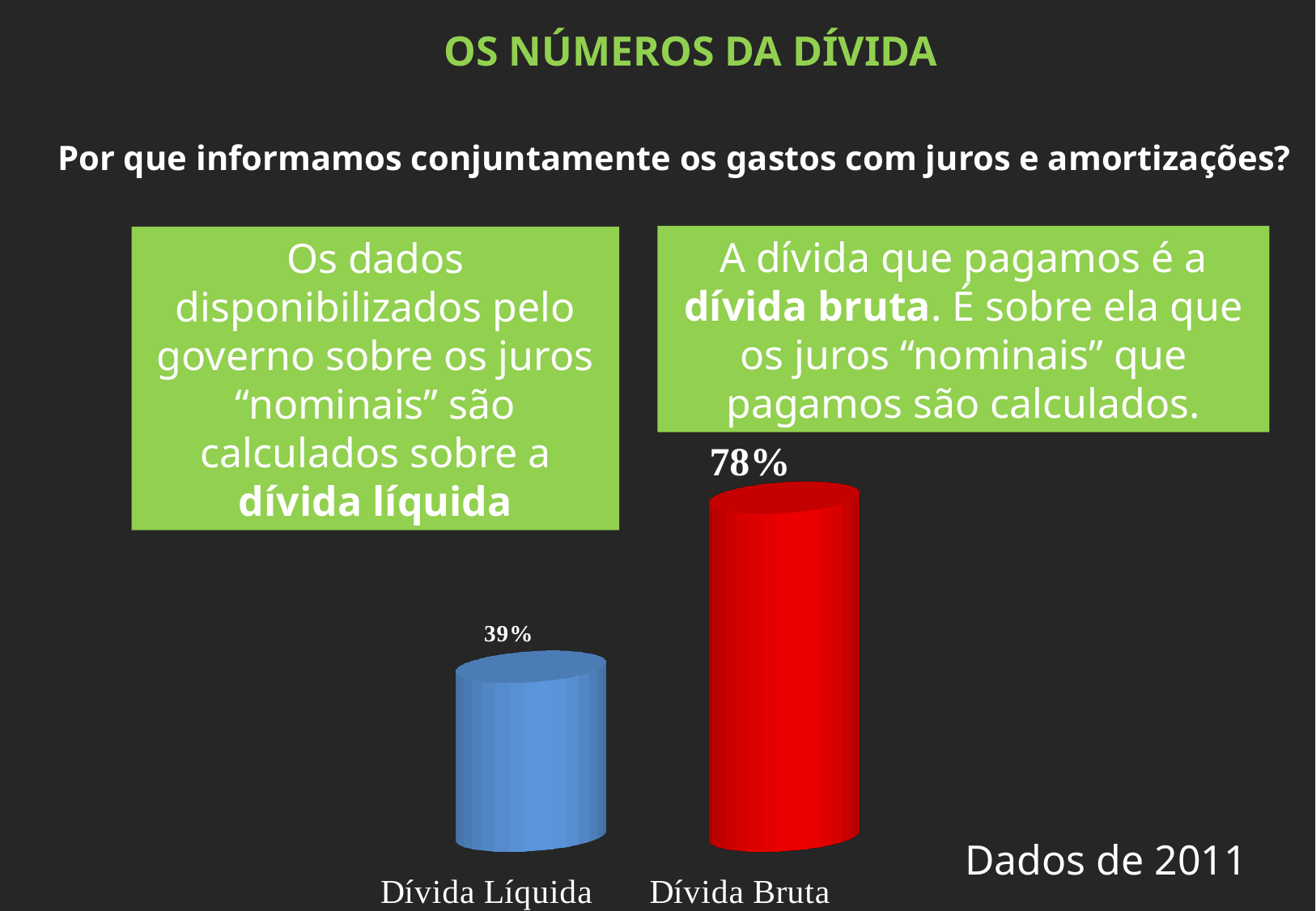
What colour is the bar for Dívida Bruta? Red What kind of chart is shown on the slide? Bar chart What is the value shown for Dívida Líquida? 39% Which is larger, the value for Dívida Líquida or the value for Dívida Bruta? Dívida Bruta Which category has the highest value? Dívida Bruta What is the difference between the values for Dívida Bruta and Dívida Líquida? 39% How many categories are shown in the chart? 2 Which category has the lowest value? Dívida Líquida What is the value shown for Dívida Bruta? 78% What colour is the bar for Dívida Líquida? Blue Do the values rise or fall from Dívida Líquida to Dívida Bruta? Rise